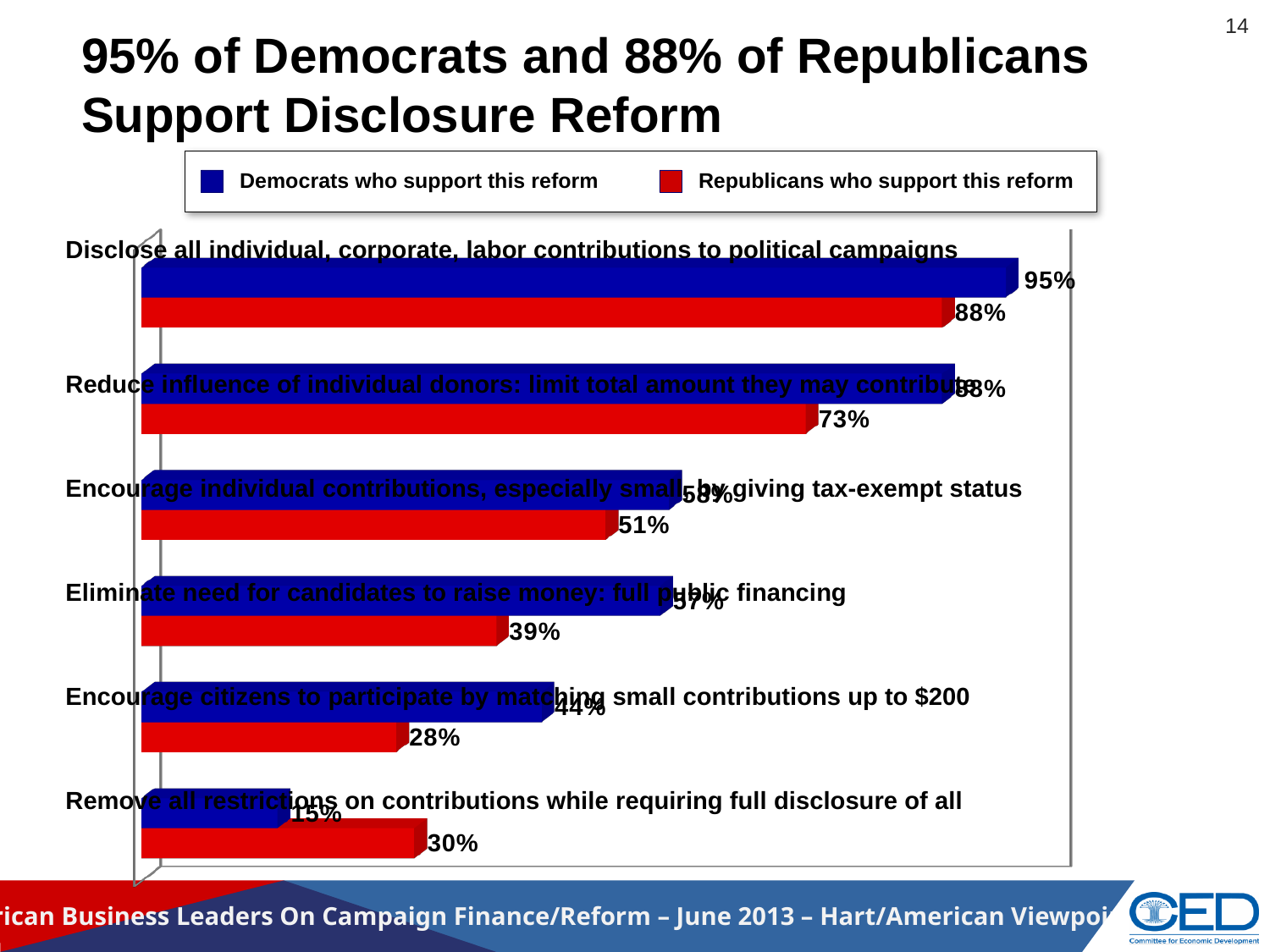
How many series does the legend list? 2 What type of chart is shown on the slide? Bar chart For removing all restrictions on contributions while requiring full disclosure, which group shows higher support, Democrats or Republicans? Republicans How many reforms are listed in the chart? 6 What percentage of Republicans support disclosing all individual, corporate, labor contributions to political campaigns? 88% What percentage of Republicans support removing all restrictions on contributions while requiring full disclosure of all? 30% What is the difference between the Democrat and Republican support for disclosing all individual, corporate, labor contributions to political campaigns? 7 percentage points Which reform has the highest share of Democrats supporting it? Disclose all individual, corporate, labor contributions to political campaigns Which reform has the lowest share of Republicans supporting it? Encourage citizens to participate by matching small contributions up to $200 What percentage of Republicans support reducing the influence of individual donors by limiting the total amount they may contribute? 73% What percentage of Democrats support disclosing all individual, corporate, labor contributions to political campaigns? 95% What percentage of Republicans support encouraging citizens to participate by matching small contributions up to $200? 28%